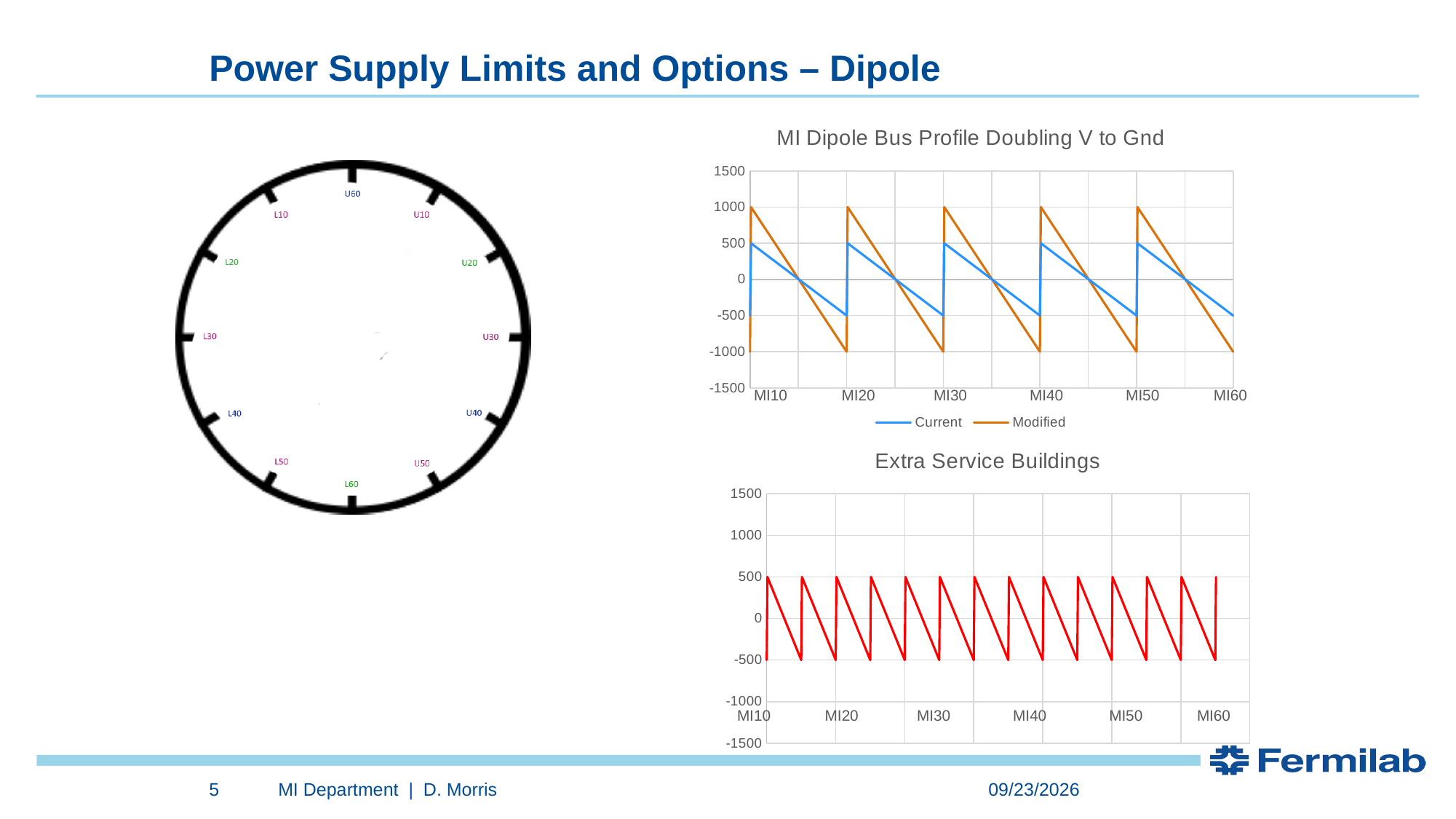
What kind of chart is the 'MI Dipole Bus Profile Doubling V to Gnd' chart? line chart On the 'Extra Service Buildings' chart, what is the lowest value reached by the red line? -500 What kind of chart is the 'Extra Service Buildings' chart? line chart On the 'MI Dipole Bus Profile Doubling V to Gnd' chart, what is the peak value reached by the Modified series? 1000 How many series does the legend of the 'MI Dipole Bus Profile Doubling V to Gnd' chart list? 2 What are the two legend entries on the 'MI Dipole Bus Profile Doubling V to Gnd' chart? Current and Modified On the 'MI Dipole Bus Profile Doubling V to Gnd' chart, which series reaches the higher peak, Current or Modified? Modified On the 'MI Dipole Bus Profile Doubling V to Gnd' chart, what is the difference between the peak of the Modified series and the peak of the Current series? 500 On the 'Extra Service Buildings' chart, what is the peak value reached by the red line? 500 On the 'MI Dipole Bus Profile Doubling V to Gnd' chart, what is the lowest value reached by the Current series? -500 How many labelled categories are on the x axis of the 'MI Dipole Bus Profile Doubling V to Gnd' chart? 6 On the 'MI Dipole Bus Profile Doubling V to Gnd' chart, is the peak value of the Modified series greater or less than 500? greater